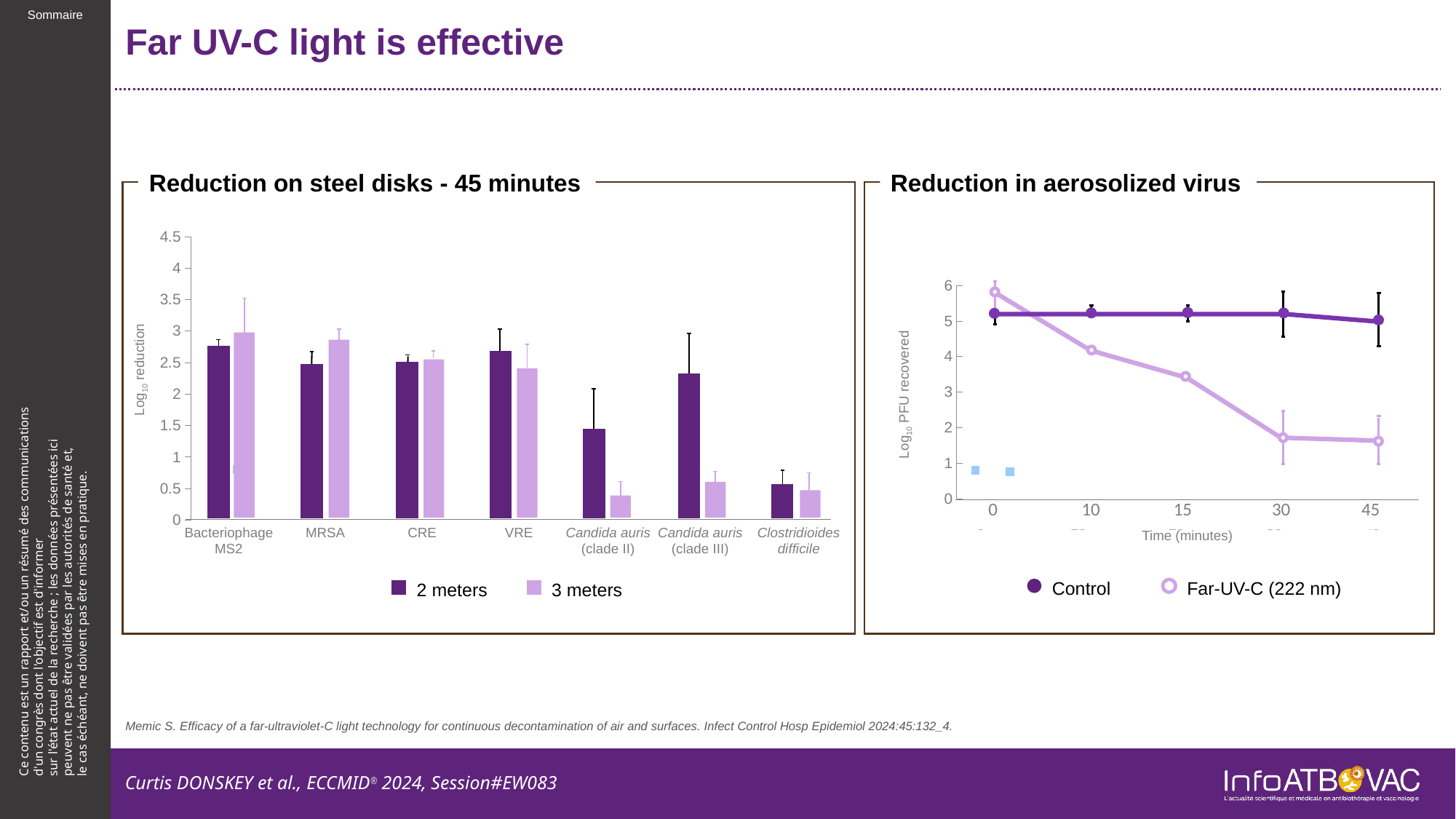
In "Reduction on steel disks - 45 minutes", for Candida auris (clade III), which is larger: the 2 meters value or the 3 meters value? 2 meters In "Reduction on steel disks - 45 minutes", is the 2 meters value for Bacteriophage MS2 greater or less than 2.5? greater In "Reduction in aerosolized virus", how many series does the legend list? 2 What kind of chart is "Reduction on steel disks - 45 minutes"? bar chart In "Reduction on steel disks - 45 minutes", which organism has the lowest 2 meters value? Clostridioides difficile In "Reduction in aerosolized virus", is the Far-UV-C (222 nm) value at 45 minutes greater or less than 2? less In "Reduction on steel disks - 45 minutes", how many organism categories are shown on the x axis? 7 In "Reduction on steel disks - 45 minutes", for MRSA, which is larger: the 2 meters value or the 3 meters value? 3 meters In "Reduction in aerosolized virus", does the Far-UV-C (222 nm) series rise or fall over time? fall In "Reduction on steel disks - 45 minutes", is the 3 meters value for Candida auris (clade II) greater or less than 1? less In "Reduction on steel disks - 45 minutes", how many series does the legend list? 2 What kind of chart is "Reduction in aerosolized virus"? line chart